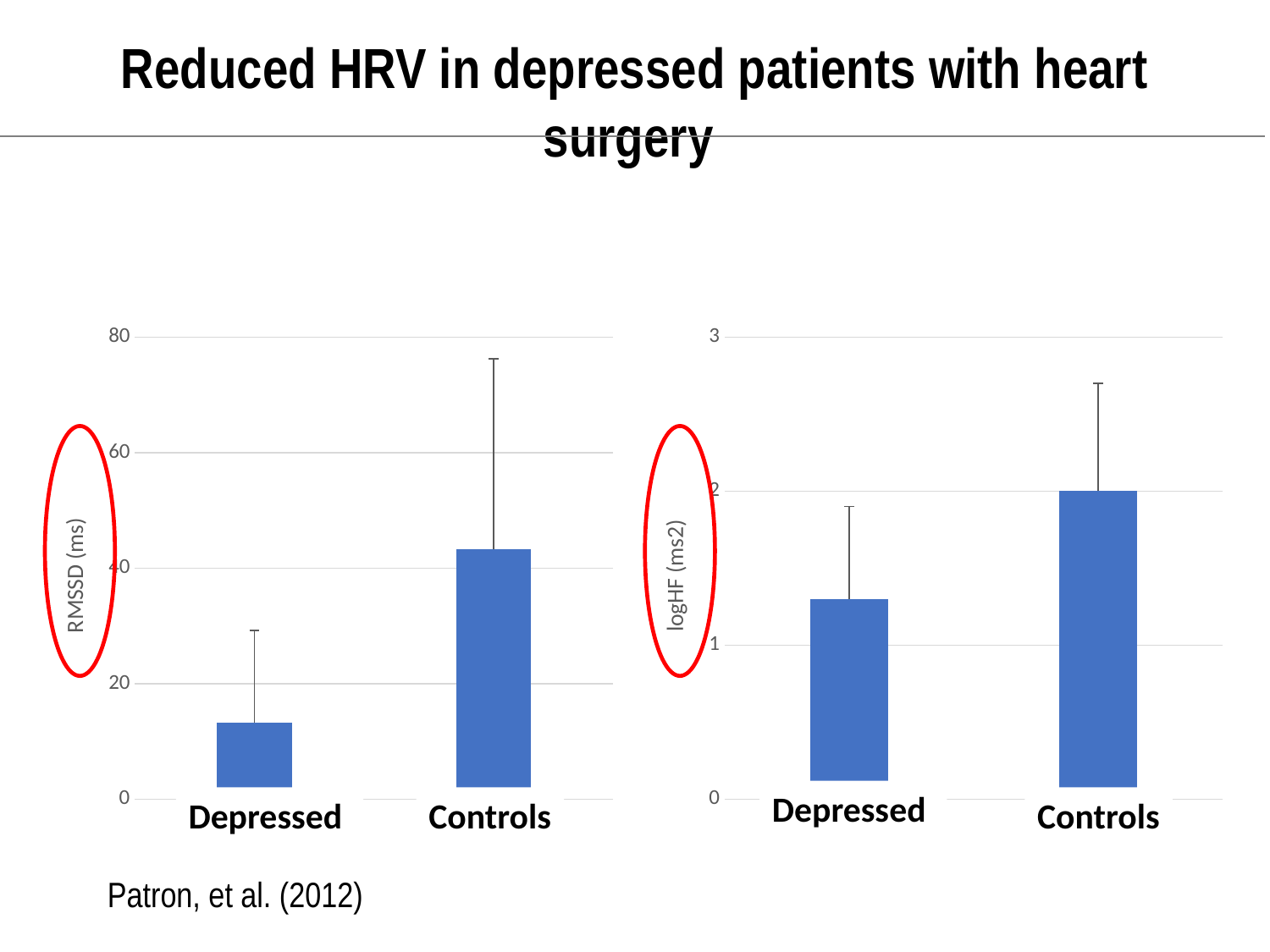
On the left chart (RMSSD), which category has the lowest value? Depressed On the right chart (logHF), which is larger, the value for Depressed or the value for Controls? Controls On the right chart (logHF), which category has the highest value? Controls On the right chart (logHF), is the value for Depressed greater or less than 2? less What is the y-axis label of the left chart? RMSSD (ms) On the left chart (RMSSD), is the value for Controls greater or less than 40? greater On the left chart (RMSSD), is the value for Depressed greater or less than 20? less On the left chart (RMSSD), which category has the highest value? Controls How many categories are shown on the left chart (RMSSD)? 2 What is the y-axis label of the right chart? logHF (ms2) What kind of chart is the left chart (RMSSD)? bar chart